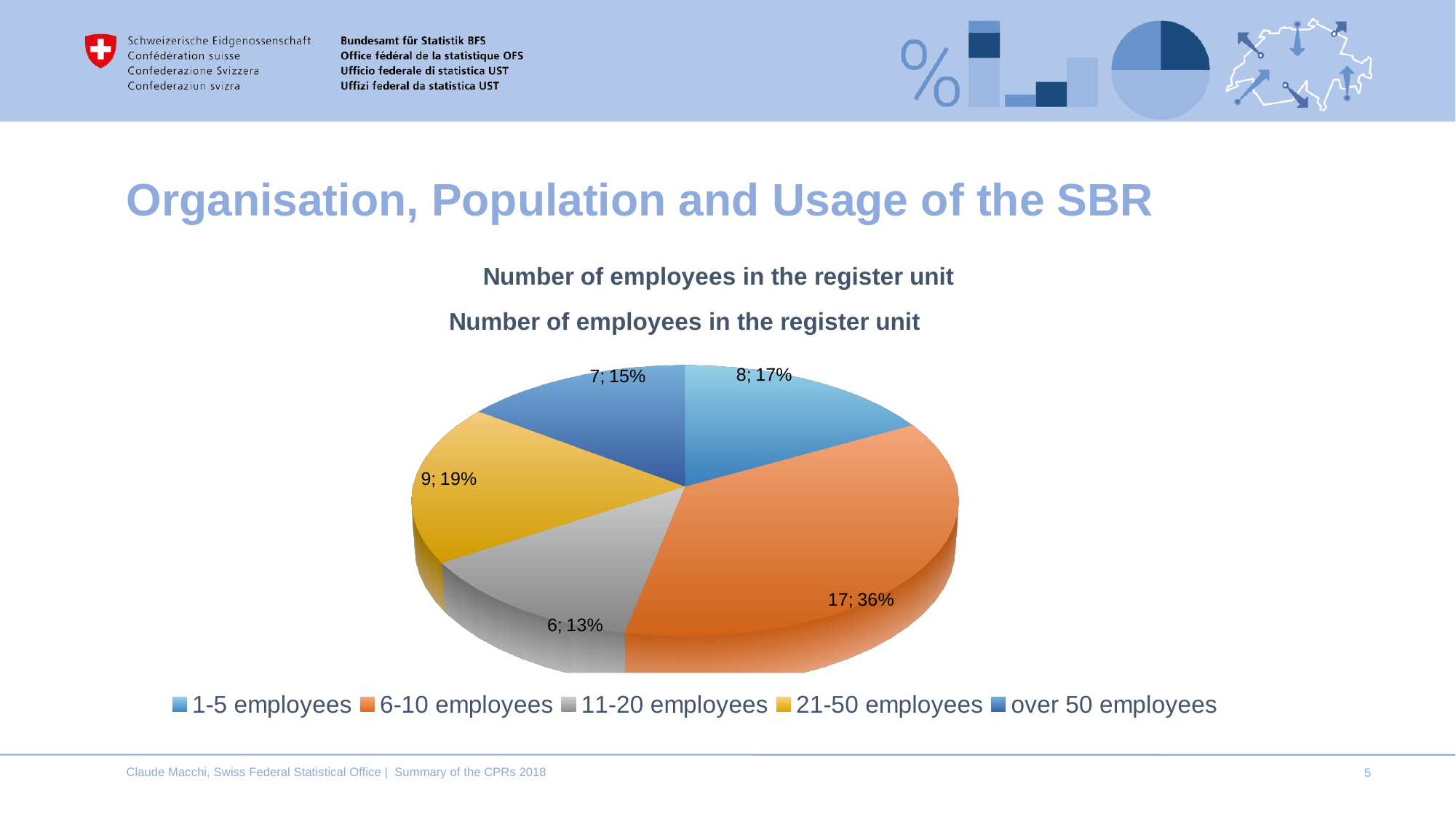
What is the count for the 6-10 employees slice? 17 What percentage share does the 1-5 employees slice have? 17% What percentage share does the 21-50 employees slice have? 19% Which is larger, the 21-50 employees slice or the over 50 employees slice? 21-50 employees What colour is the 21-50 employees slice? yellow What is the count for the over 50 employees slice? 7 How many categories does the pie chart have? 5 What kind of chart is shown on the slide? pie chart Which category has the largest slice of the pie? 6-10 employees What is the title of the chart? Number of employees in the register unit Which category has the smallest slice of the pie? 11-20 employees What is the difference in count between the 6-10 employees slice and the 11-20 employees slice? 11